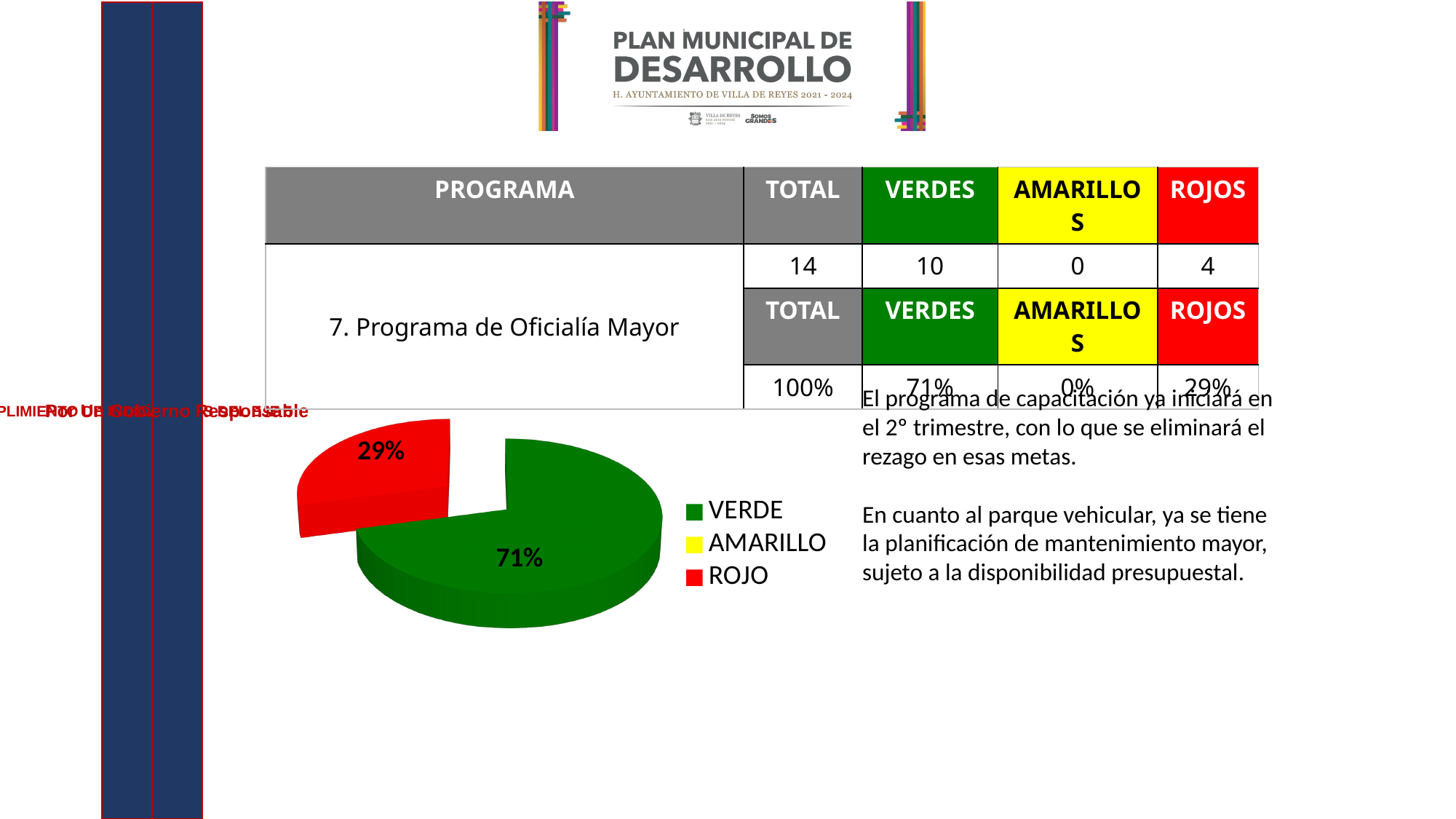
Is the share of the VERDE slice greater or less than 50%? greater What kind of chart is shown on the slide? pie chart Which category has the largest slice of the pie? VERDE What is the difference in percentage points between the VERDE and ROJO slices? 42% What share of the pie does the VERDE slice represent? 71% Which of the two visible slices is larger, VERDE or ROJO? VERDE How many entries does the pie chart legend list? 3 Which legend entry is shown in green? VERDE Which legend entry is shown in red? ROJO What share of the pie does the ROJO slice represent? 29% Is the share of the ROJO slice greater or less than 50%? less